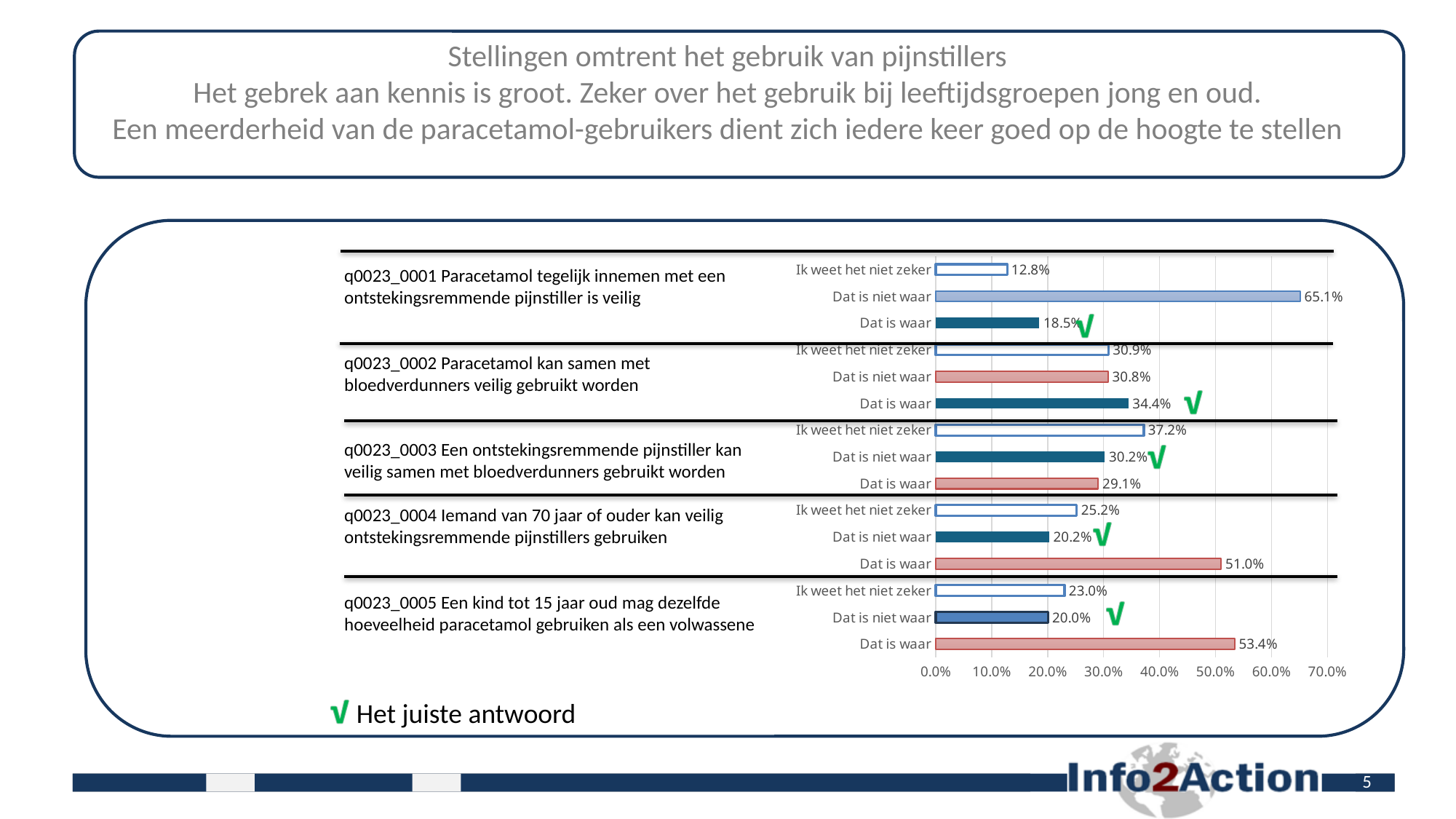
For statement q0023_0004, which answer has the larger share: 'Dat is waar' or 'Dat is niet waar'? Dat is waar What percentage answered 'Ik weet het niet zeker' for statement q0023_0003? 37.2% What percentage answered 'Dat is niet waar' for statement q0023_0001 (Paracetamol tegelijk innemen met een ontstekingsremmende pijnstiller is veilig)? 65.1% For statement q0023_0004, what is the difference between 'Dat is waar' and 'Ik weet het niet zeker'? 25.8 percentage points Which bar in the chart has the highest value? Dat is niet waar for q0023_0001 (65.1%) Which bar in the chart has the lowest value? Ik weet het niet zeker for q0023_0001 (12.8%) What percentage answered 'Dat is waar' for statement q0023_0002 (Paracetamol kan samen met bloedverdunners veilig gebruikt worden)? 34.4% For statement q0023_0001, what is the difference between 'Dat is niet waar' and 'Dat is waar'? 46.6 percentage points What kind of chart is shown on the slide? bar chart What percentage answered 'Dat is waar' for statement q0023_0005 (Een kind tot 15 jaar oud mag dezelfde hoeveelheid paracetamol gebruiken als een volwassene)? 53.4% How many bars are plotted in the chart in total? 15 Is the value for 'Dat is niet waar' in statement q0023_0001 greater or less than 60.0%? greater